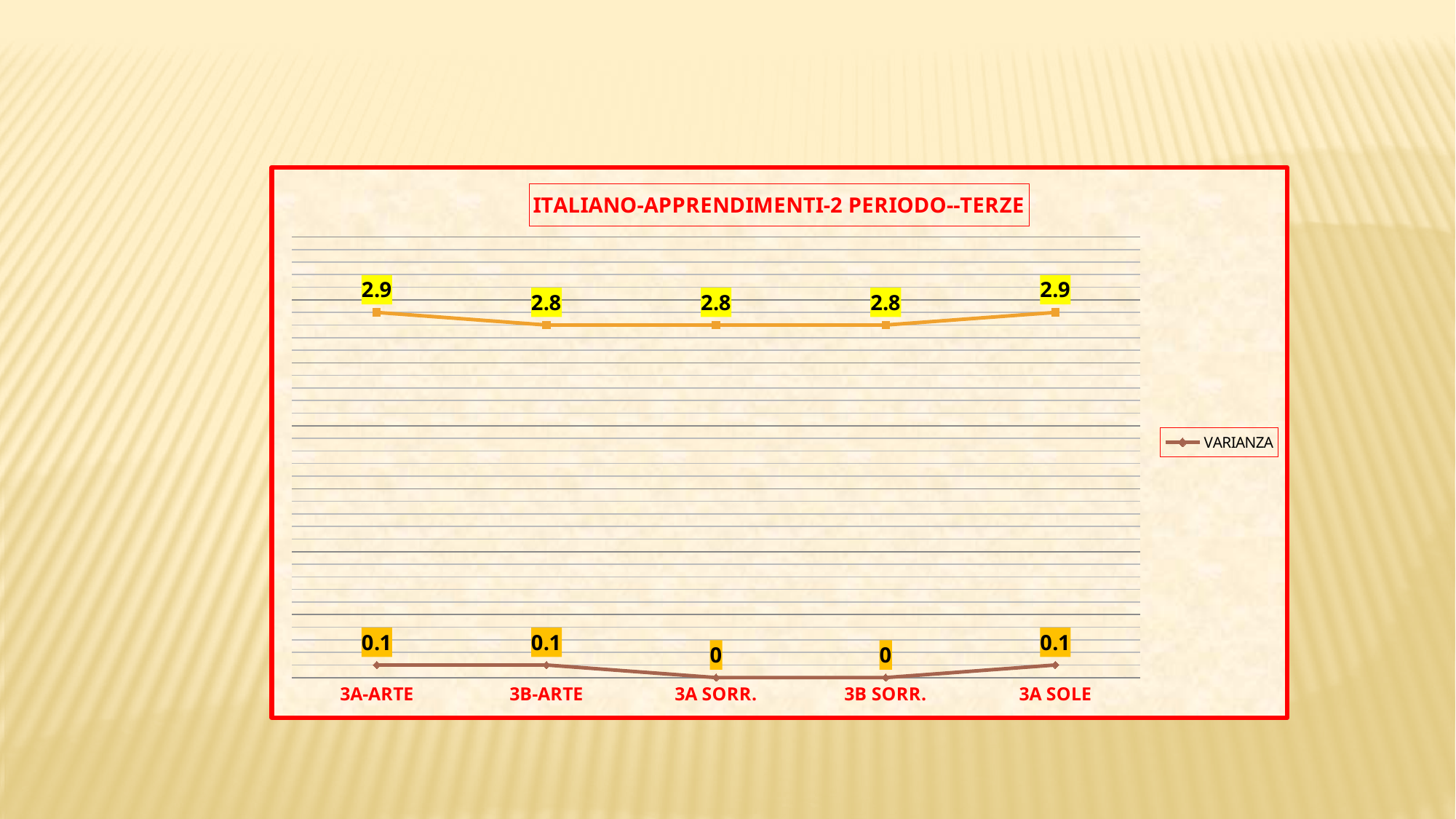
What is the difference between the upper (orange) line values for 3A-ARTE and 3A SORR.? 0.1 How many series does the chart's legend list? 1 How many categories are shown on the x axis of the chart? 5 What is the value of the upper (orange) line for 3B-ARTE? 2.8 What is the title of the chart? ITALIANO-APPRENDIMENTI-2 PERIODO--TERZE What is the VARIANZA value for 3A SOLE? 0.1 What is the VARIANZA value for 3A SORR.? 0 Which categories have the lowest VARIANZA value? 3A SORR. and 3B SORR. What is the VARIANZA value for 3A-ARTE? 0.1 Is the VARIANZA value for 3B-ARTE larger or smaller than the VARIANZA value for 3B SORR.? larger What type of chart is shown on the slide? line chart What is the value of the upper (orange) line for 3A SOLE? 2.9